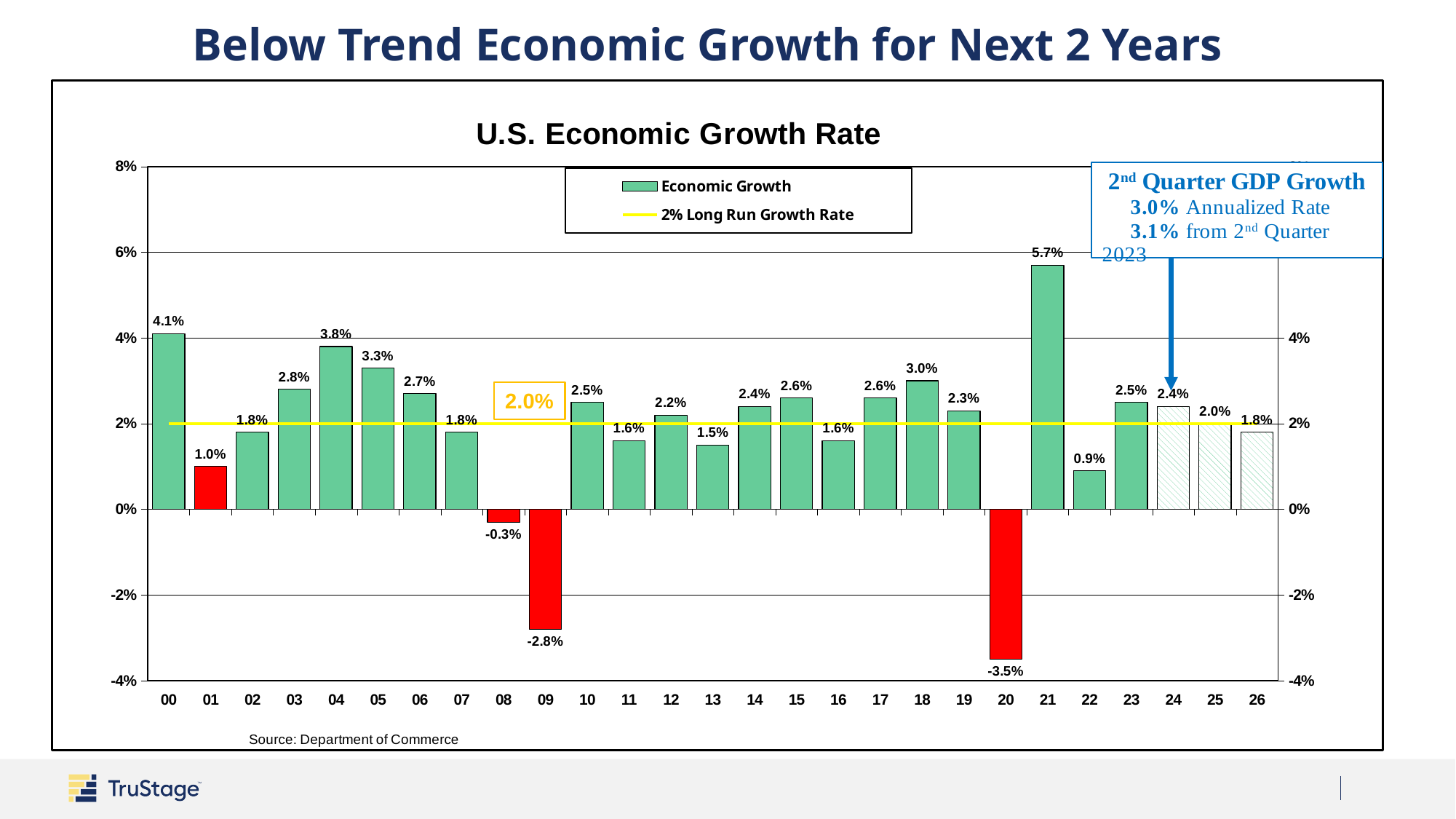
Is the growth rate for 2000 (00) greater or less than 4%? greater What is the source cited for the chart data? Department of Commerce How many entries does the chart legend list? 2 What is the economic growth rate shown for 2009 (09)? -2.8% Which year has the highest economic growth rate on the chart? 21 Which year has the lowest economic growth rate on the chart? 20 What is the economic growth rate shown for 2025 (25)? 2.0% How many years are shown on the x axis of the chart? 27 What kind of chart is used to show the U.S. Economic Growth Rate? Bar chart What is the difference between the growth rate in 2021 (21) and in 2022 (22)? 4.8% What is the economic growth rate shown for 2021 (21)? 5.7% Which year has the larger growth rate, 2004 (04) or 2018 (18)? 04